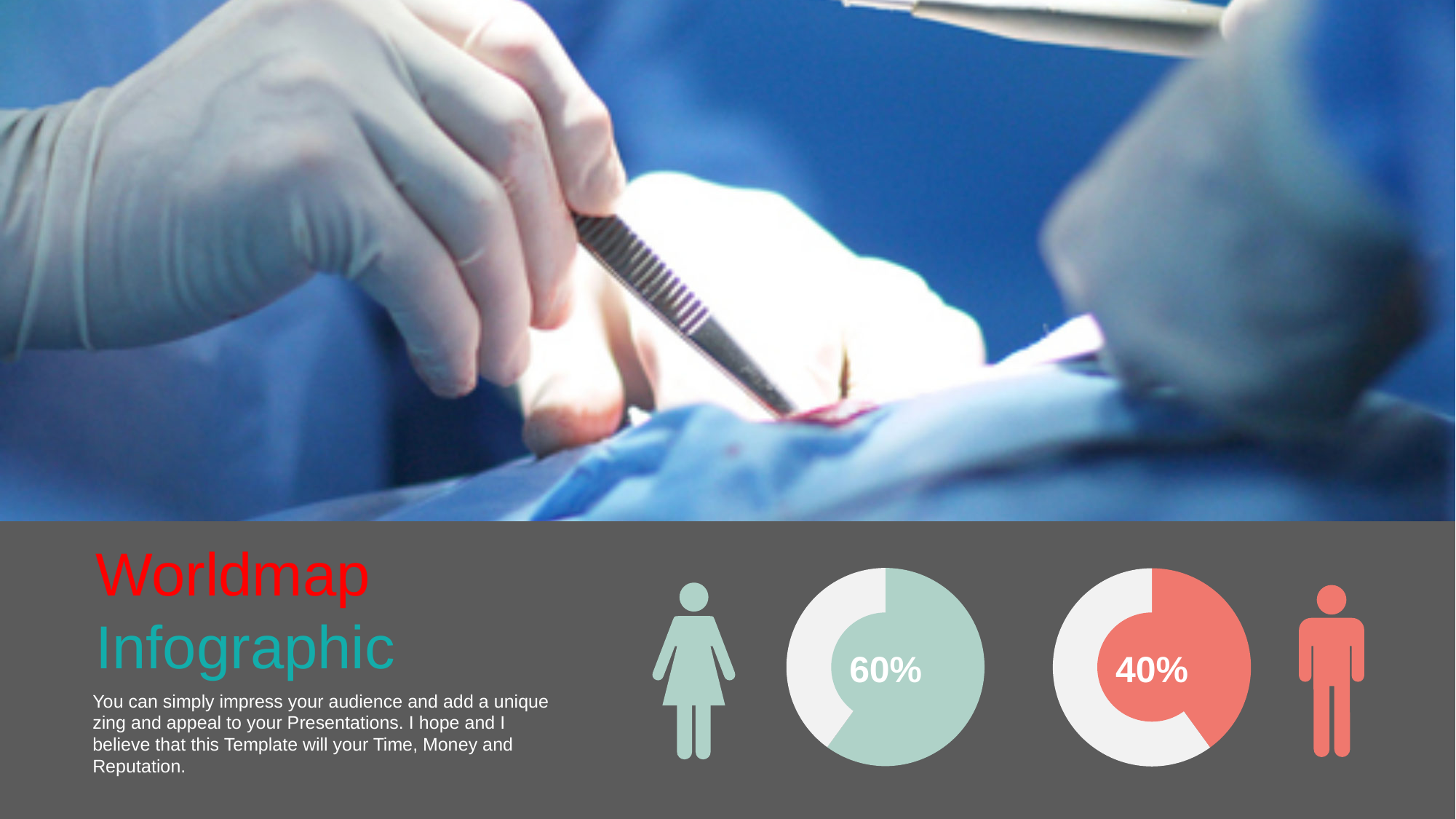
Which pie chart shows the larger percentage, the left one (female) or the right one (male)? the left one (female) On the left pie chart, what share of the pie does the coloured (filled) slice represent? 60% What is the difference between the percentage on the left pie chart and the percentage on the right pie chart? 20% Is the value on the left pie chart greater or less than 50%? greater What colour is the filled slice of the left pie chart, next to the female figure? light green (mint) What colour is the filled slice of the right pie chart, next to the male figure? red (salmon) Is the value on the right pie chart greater or less than 50%? less What percentage is shown on the left pie chart, next to the female figure? 60% What percentage is shown on the right pie chart, next to the male figure? 40% How many pie charts are shown on the slide? 2 On the right pie chart, what share of the pie does the coloured (filled) slice represent? 40% What kind of chart is used to display the 60% and 40% values on the slide? doughnut chart